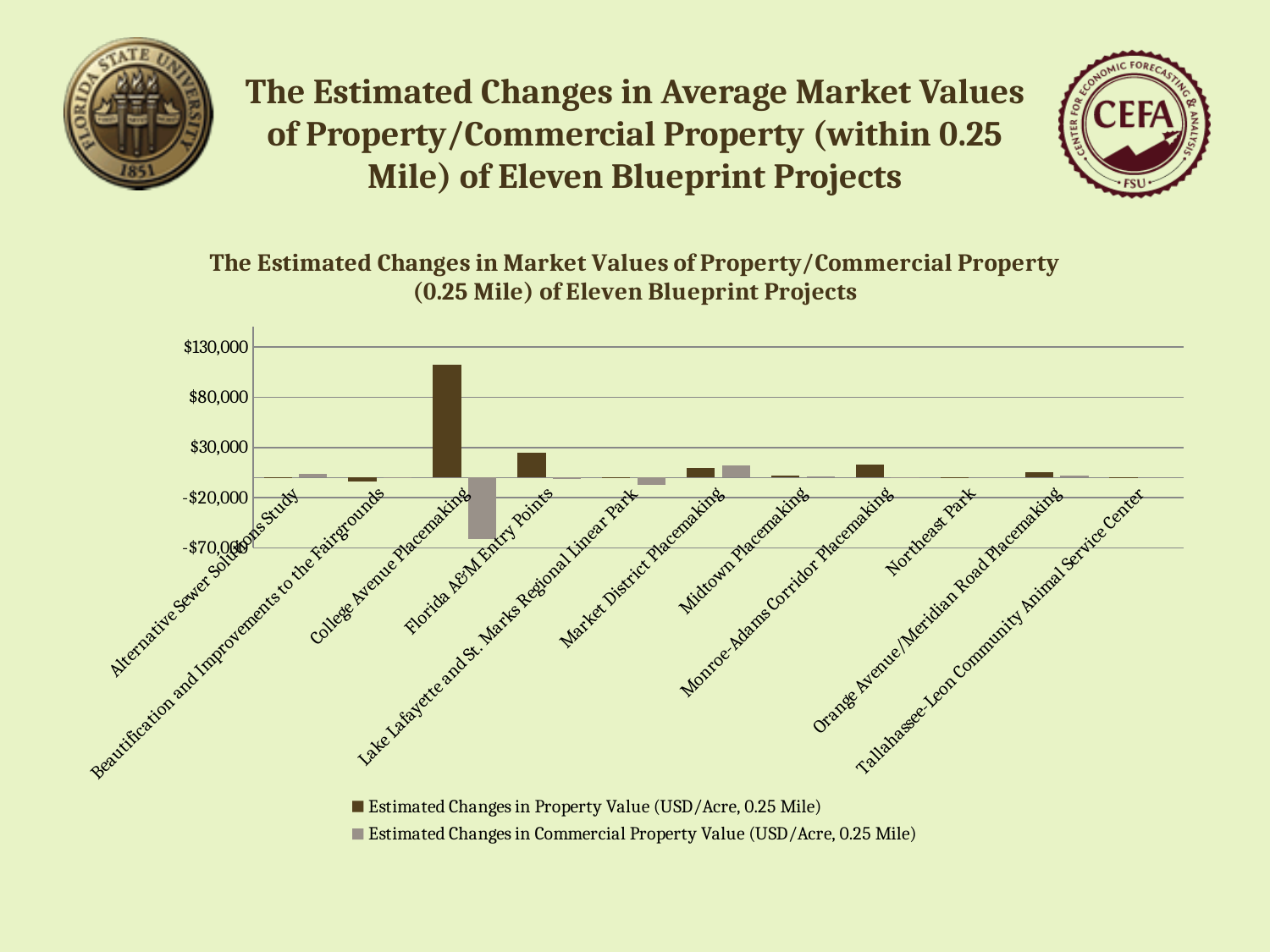
Is the Estimated Changes in Property Value for Florida A&M Entry Points greater or less than $30,000? less Which project has the highest Estimated Changes in Commercial Property Value (USD/Acre, 0.25 Mile)? Market District Placemaking Is the Estimated Changes in Property Value for College Avenue Placemaking greater or less than $80,000? greater How many Blueprint projects (categories) are shown on the x axis of the chart? 11 Which project has the highest Estimated Changes in Property Value (USD/Acre, 0.25 Mile)? College Avenue Placemaking Which project has the lowest Estimated Changes in Commercial Property Value (USD/Acre, 0.25 Mile)? College Avenue Placemaking Which series is shown in dark brown in the chart's legend? Estimated Changes in Property Value (USD/Acre, 0.25 Mile) Is the Estimated Changes in Commercial Property Value for College Avenue Placemaking greater or less than -$20,000? less How many series does the chart's legend list? 2 Which project has a larger Estimated Changes in Property Value: Florida A&M Entry Points or Monroe-Adams Corridor Placemaking? Florida A&M Entry Points Which project has a larger Estimated Changes in Property Value: College Avenue Placemaking or Florida A&M Entry Points? College Avenue Placemaking What kind of chart is shown on the slide? bar chart